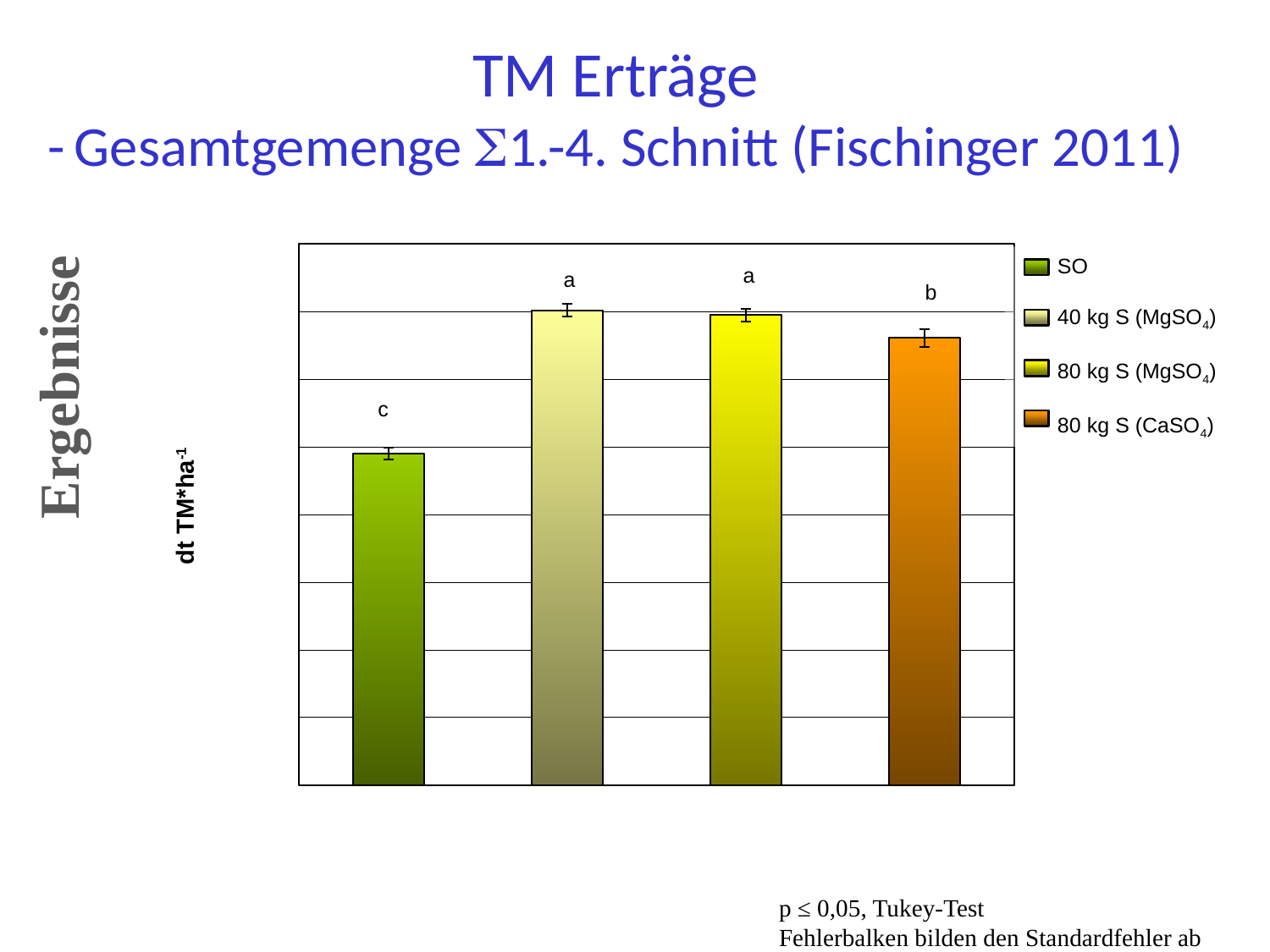
Which is larger, the value for 80 kg S (MgSO4) or the value for 80 kg S (CaSO4)? 80 kg S (MgSO4) What significance letter is printed above the SO bar? c Which is larger, the value for SO or the value for 80 kg S (CaSO4)? 80 kg S (CaSO4) How many bars are plotted in the chart? 4 Which is larger, the value for SO or the value for 40 kg S (MgSO4)? 40 kg S (MgSO4) What is the label on the y axis of the chart? dt TM*ha-1 How many entries does the legend list? 4 What kind of chart is shown on the slide? bar chart Which treatment has the lowest TM yield? SO